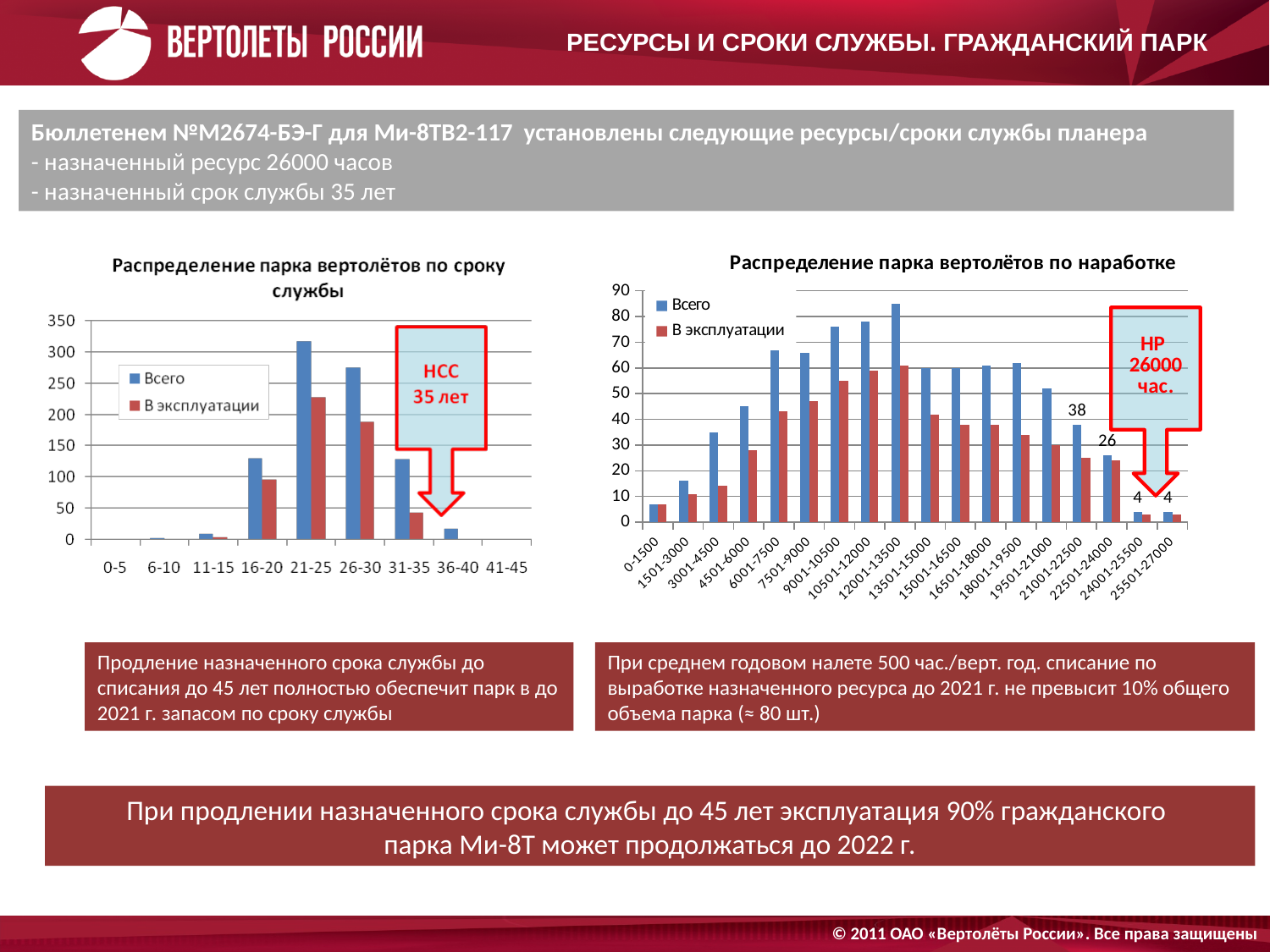
What kind of chart is "Распределение парка вертолётов по сроку службы"? bar chart In "Распределение парка вертолётов по наработке", what is the "Всего" value for 21001-22500? 38 In "Распределение парка вертолётов по сроку службы", is the "Всего" value for 16-20 greater or less than 150? less In "Распределение парка вертолётов по наработке", what is the difference between the "Всего" values for 21001-22500 and 22501-24000? 12 In "Распределение парка вертолётов по сроку службы", which category has the highest "Всего" value? 21-25 What text is in the callout annotation on "Распределение парка вертолётов по наработке"? НР 26000 час. In "Распределение парка вертолётов по сроку службы", which is larger, the "Всего" value for 21-25 or for 26-30? 21-25 In "Распределение парка вертолётов по сроку службы", is the "Всего" value for 21-25 greater or less than 300? greater How many categories are shown on the x axis of "Распределение парка вертолётов по сроку службы"? 9 How many series does the legend of "Распределение парка вертолётов по наработке" list? 2 In "Распределение парка вертолётов по наработке", which category has the highest "Всего" value? 12001-13500 In "Распределение парка вертолётов по наработке", what is the "Всего" value for 22501-24000? 26